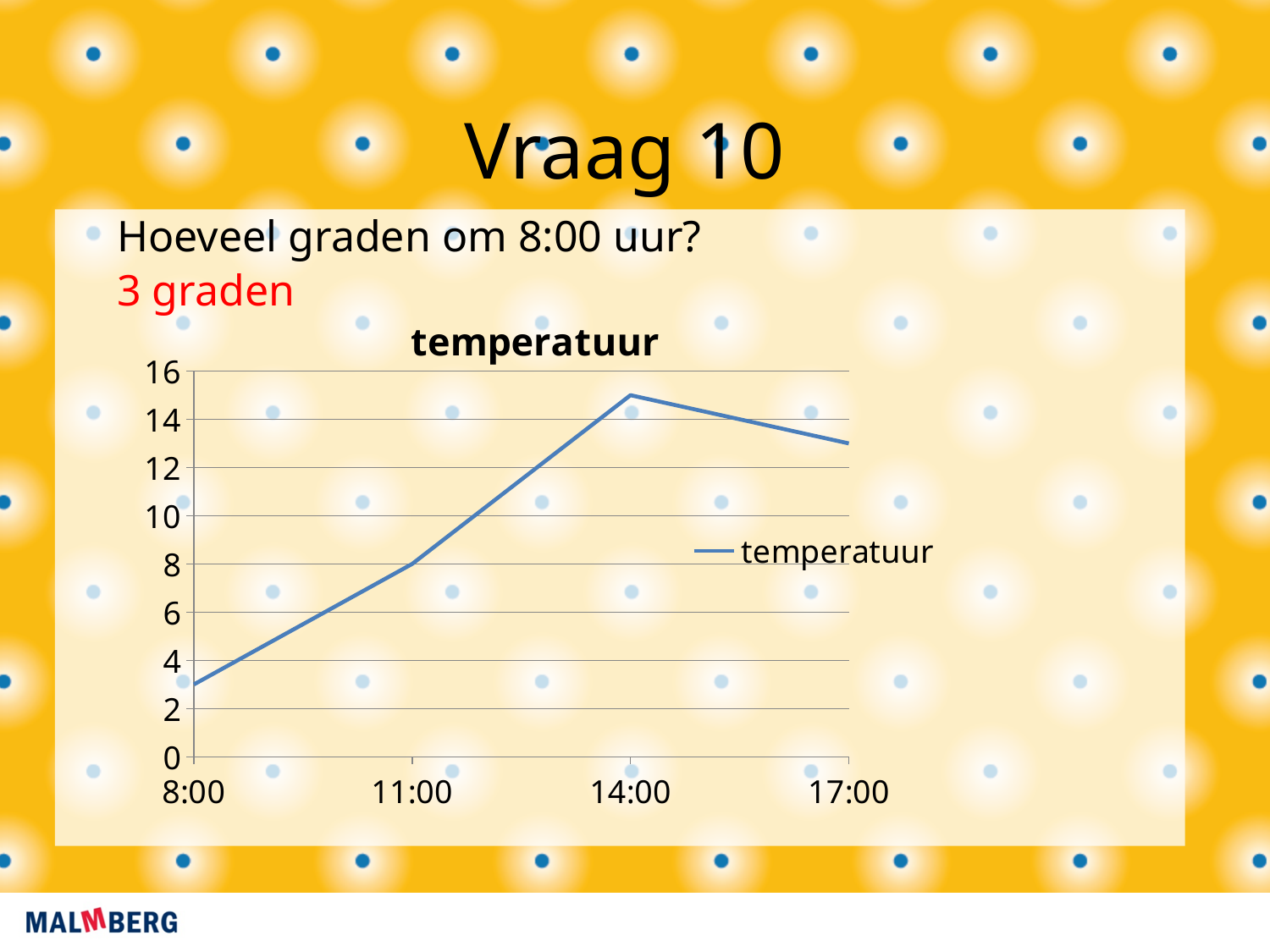
How many time points are labelled on the x axis? 4 What kind of chart is shown on the slide? line chart Which is larger, the temperature at 11:00 or at 17:00? 17:00 At which time is the temperature lowest? 8:00 Does the temperature rise or fall between 8:00 and 14:00? rise How many series does the legend list? 1 Is the temperature at 14:00 greater or less than 14? greater What is the title of the chart? temperatuur What is the temperature at 8:00? 3 graden Is the temperature at 11:00 greater or less than 10? less Is the temperature at 17:00 greater or less than 12? greater At which time is the temperature highest? 14:00